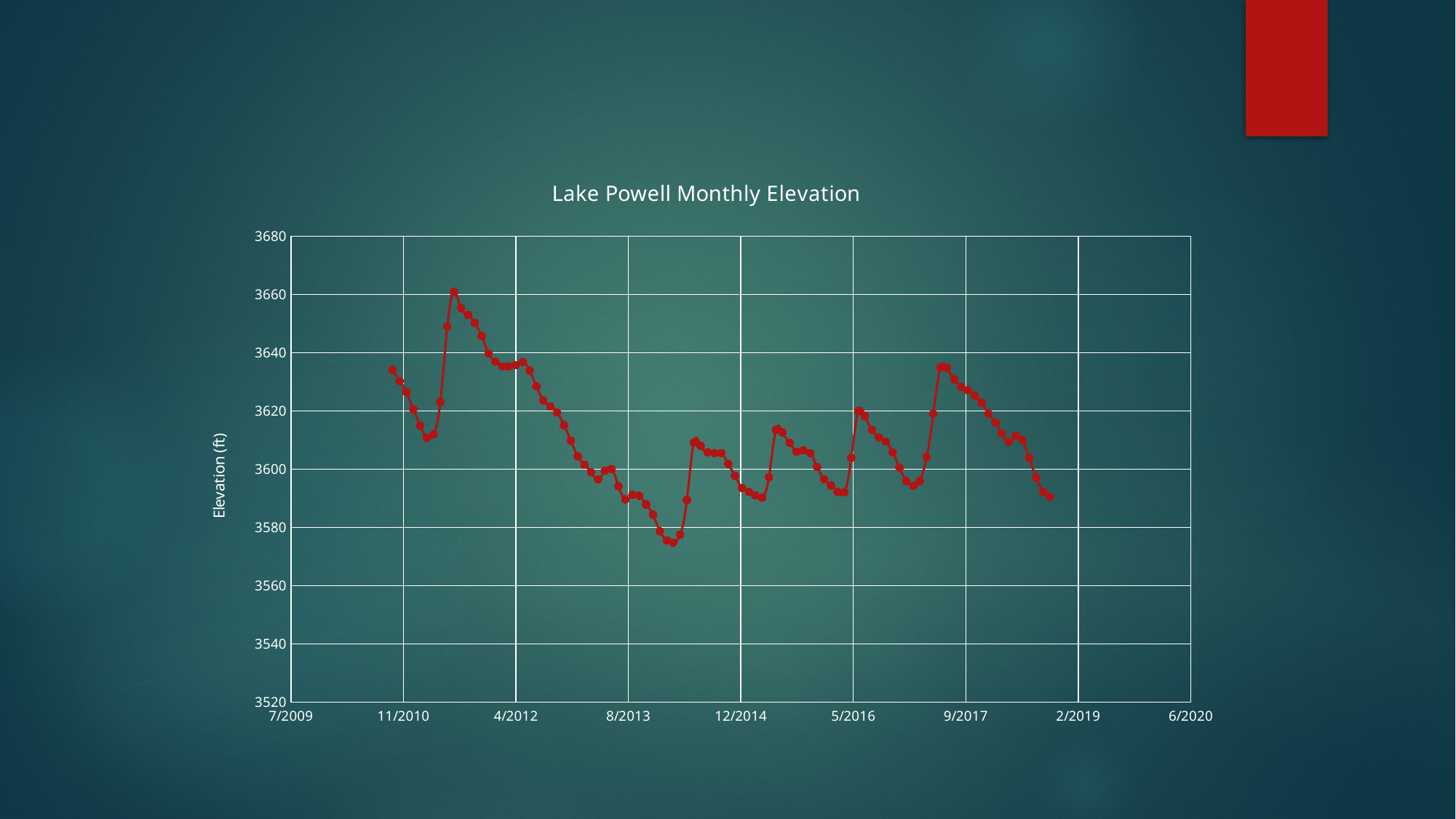
Is the highest point on the line greater or less than 3640? greater What is the highest value shown on the vertical axis? 3680 Is the last plotted point on the line greater or less than 3600? less Is the lowest point on the line greater or less than 3580? less What kind of chart is shown on the slide? line chart Which is higher: the peak in early 2011 or the peak in mid-2017? the peak in early 2011 What is the label on the vertical axis of the chart? Elevation (ft) What is the title of the chart? Lake Powell Monthly Elevation Overall, does the elevation rise or fall from the first plotted point to the last plotted point? fall